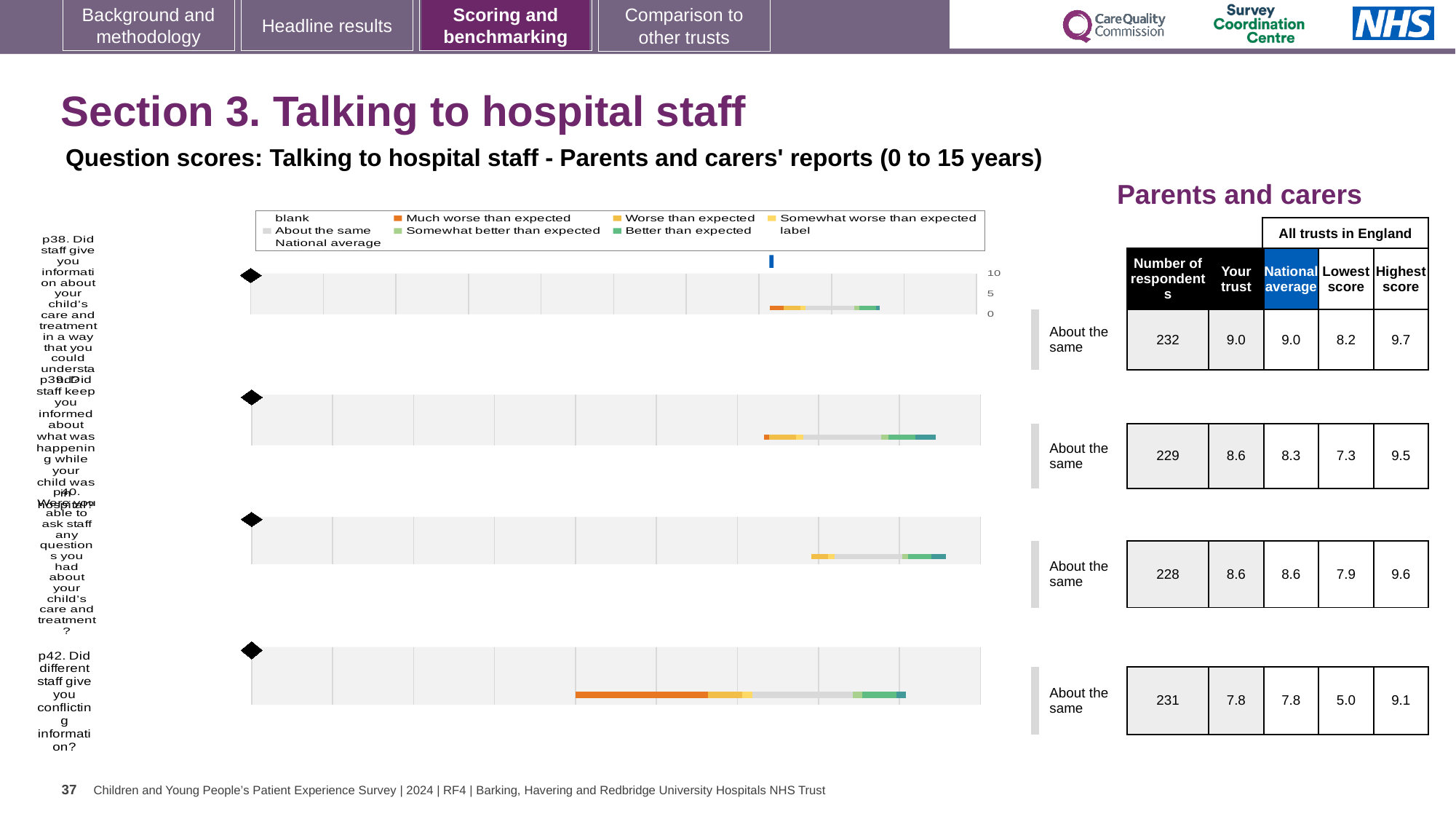
What is the 'Your trust' score for p38 (Did staff give you information about your child's care and treatment in a way that you could understand)? 9.0 What is the national average score for p42 (Did different staff give you conflicting information)? 7.8 How many respondents answered p39 (Did staff keep you informed about what was happening while your child was in hospital)? 229 What benchmark category is shown for all four questions? About the same Which has the larger 'Your trust' score, p38 or p42? p38 Which question has the lowest 'Your trust' score? p42 Which question has the highest 'Your trust' score? p38 What is the lowest score across all trusts in England for p42? 5.0 How many survey questions (bars) are plotted in the chart? 4 What kind of chart is shown on the slide? bar chart For p39, how much higher is the 'Your trust' score than the national average? 0.3 What is the highest score across all trusts in England for p40 (Were you able to ask staff any questions you had about your child's care and treatment)? 9.6